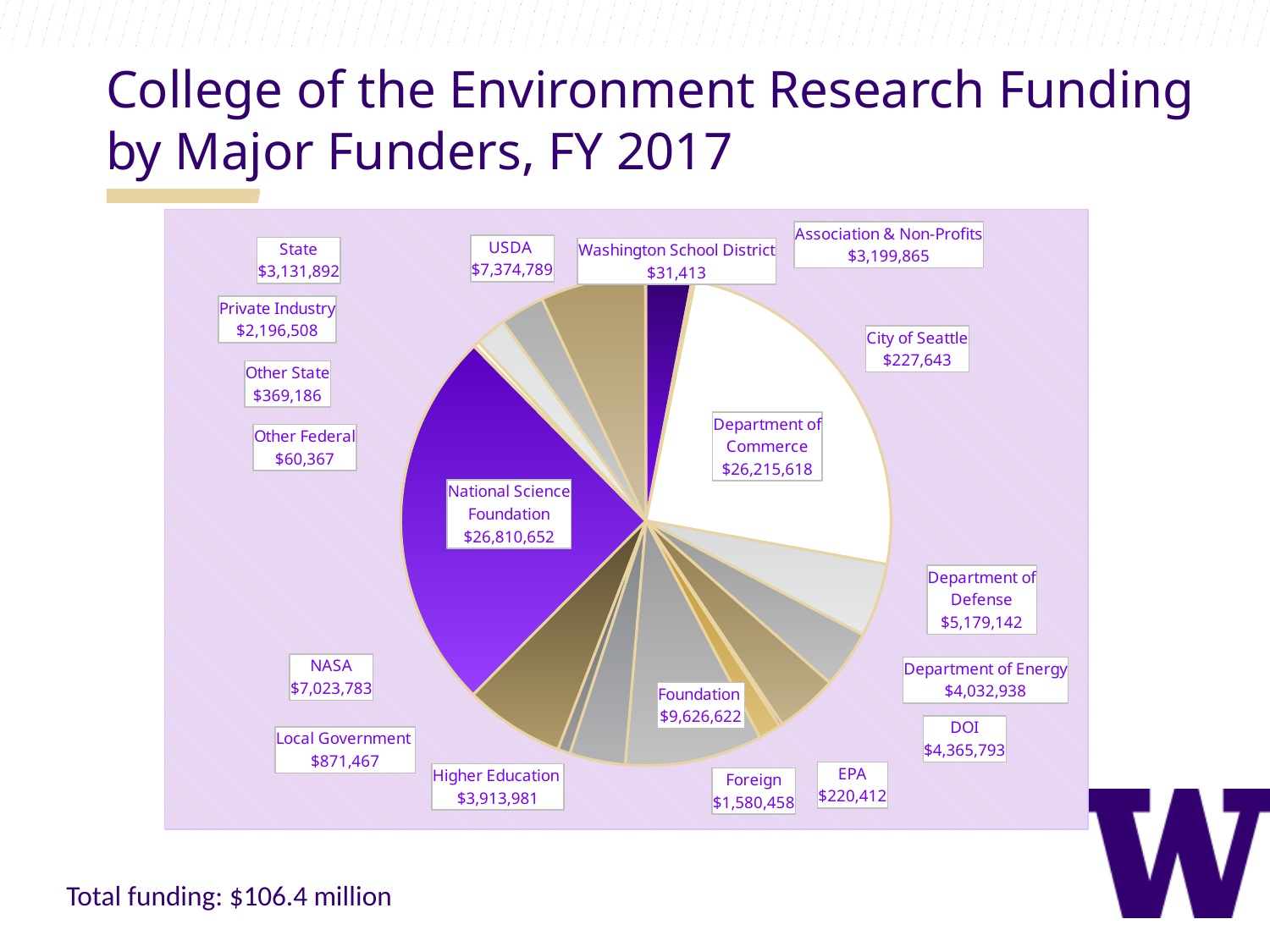
How many funder categories are shown in the pie chart? 19 What is the funding amount for the Washington School District? $31,413 What is the title of the slide containing the chart? College of the Environment Research Funding by Major Funders, FY 2017 What is the difference between the National Science Foundation and Department of Commerce funding amounts? $595,034 What is the funding amount for Foundation? $9,626,622 What is the difference between the USDA and NASA funding amounts? $351,006 Which funder has the smallest funding amount? Washington School District What is the funding amount for the Department of Commerce? $26,215,618 Which is larger, the funding from DOI or from the Department of Energy? DOI What is the funding amount for the National Science Foundation? $26,810,652 What type of chart is shown on the slide? Pie chart Which funder has the largest slice of the pie? National Science Foundation